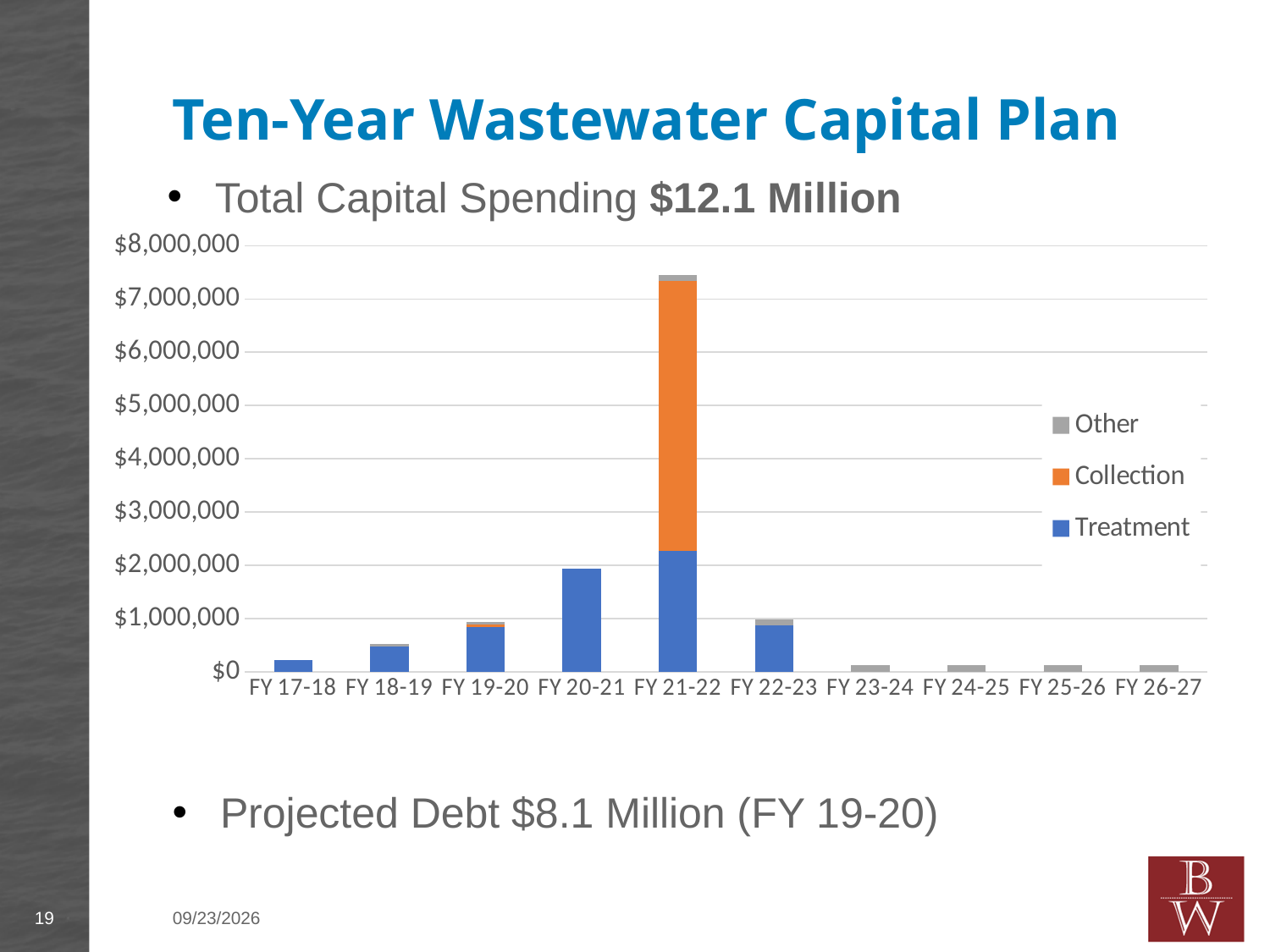
Is the total bar for FY 21-22 greater or less than $7,000,000? greater Which series is shown in orange in the chart? Collection How many series does the chart's legend list? 3 Which fiscal year has the highest total capital spending in the chart? FY 21-22 Which bar is taller, FY 22-23 or FY 24-25? FY 22-23 Is the total bar for FY 17-18 greater or less than $1,000,000? less What kind of chart is shown on the slide? Stacked bar chart How many fiscal years are shown on the x axis of the chart? 10 Is the Treatment portion of the FY 21-22 bar greater or less than $2,000,000? greater Which bar is taller, FY 20-21 or FY 18-19? FY 20-21 Which series is shown in blue in the chart? Treatment